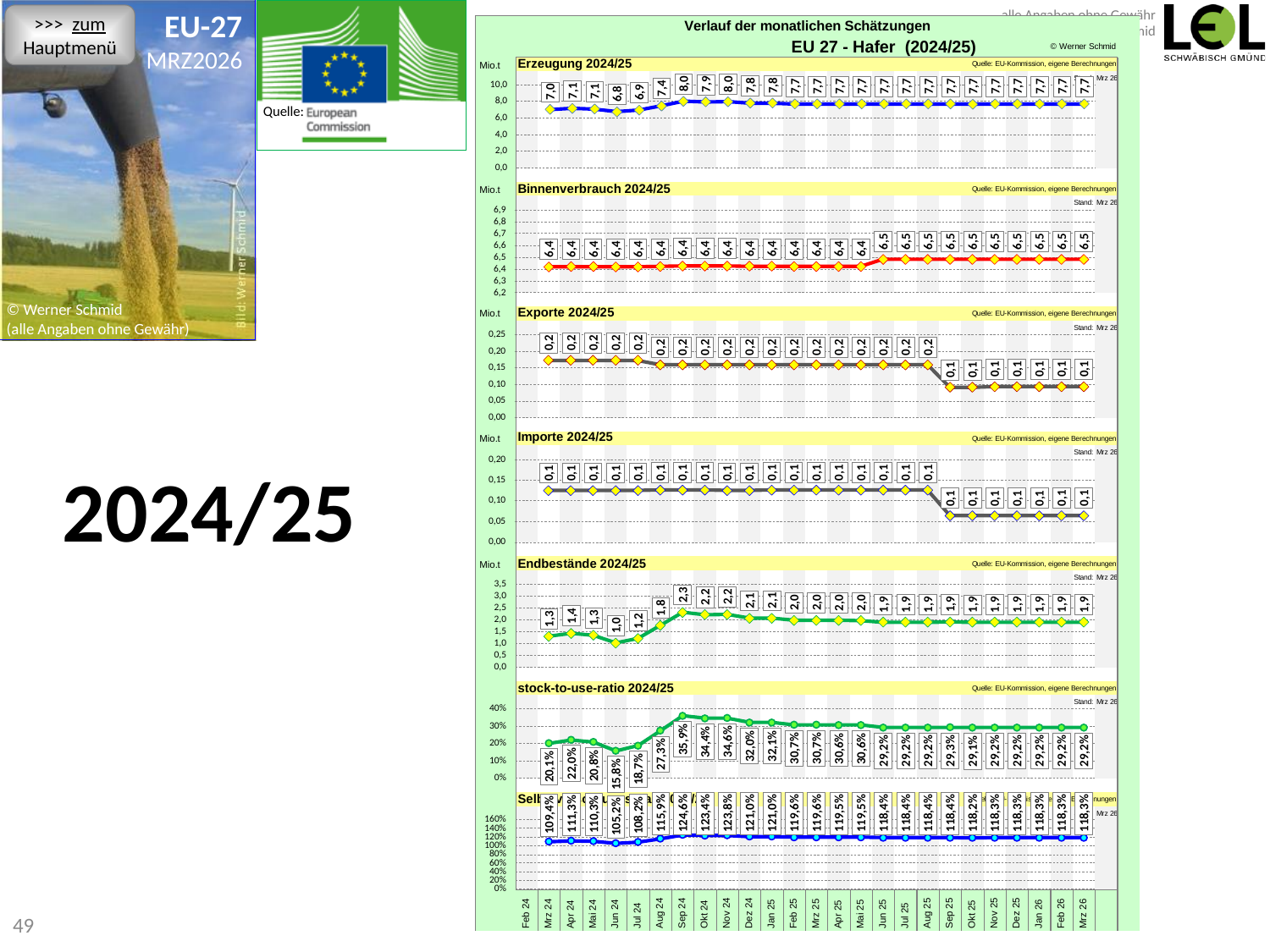
Which is larger at the last point (Mrz 26): the 'Erzeugung 2024/25' value or the 'Binnenverbrauch 2024/25' value? Erzeugung 2024/25 What kind of chart is used for the 'Erzeugung 2024/25' panel? line chart In the 'Erzeugung 2024/25' chart, what is the value at the last point (Mrz 26)? 7,7 In the 'Erzeugung 2024/25' chart, what is the lowest value shown? 6,8 In the 'Endbestände 2024/25' chart, what is the lowest value shown? 1,0 In the 'Binnenverbrauch 2024/25' chart, what is the value at the last point (Mrz 26)? 6,5 In the bottom chart (Selbstversorgungsgrad), what is the highest value shown? 124,6% In the 'Exporte 2024/25' chart, what is the value at the last point (Mrz 26)? 0,1 In the 'Endbestände 2024/25' chart, what is the highest value shown? 2,3 In the 'stock-to-use-ratio 2024/25' chart, what is the highest value shown? 35,9% In the 'stock-to-use-ratio 2024/25' chart, what is the value at the last point (Mrz 26)? 29,2% In the 'Endbestände 2024/25' chart, what is the difference between the highest value (2,3) and the lowest value (1,0)? 1,3